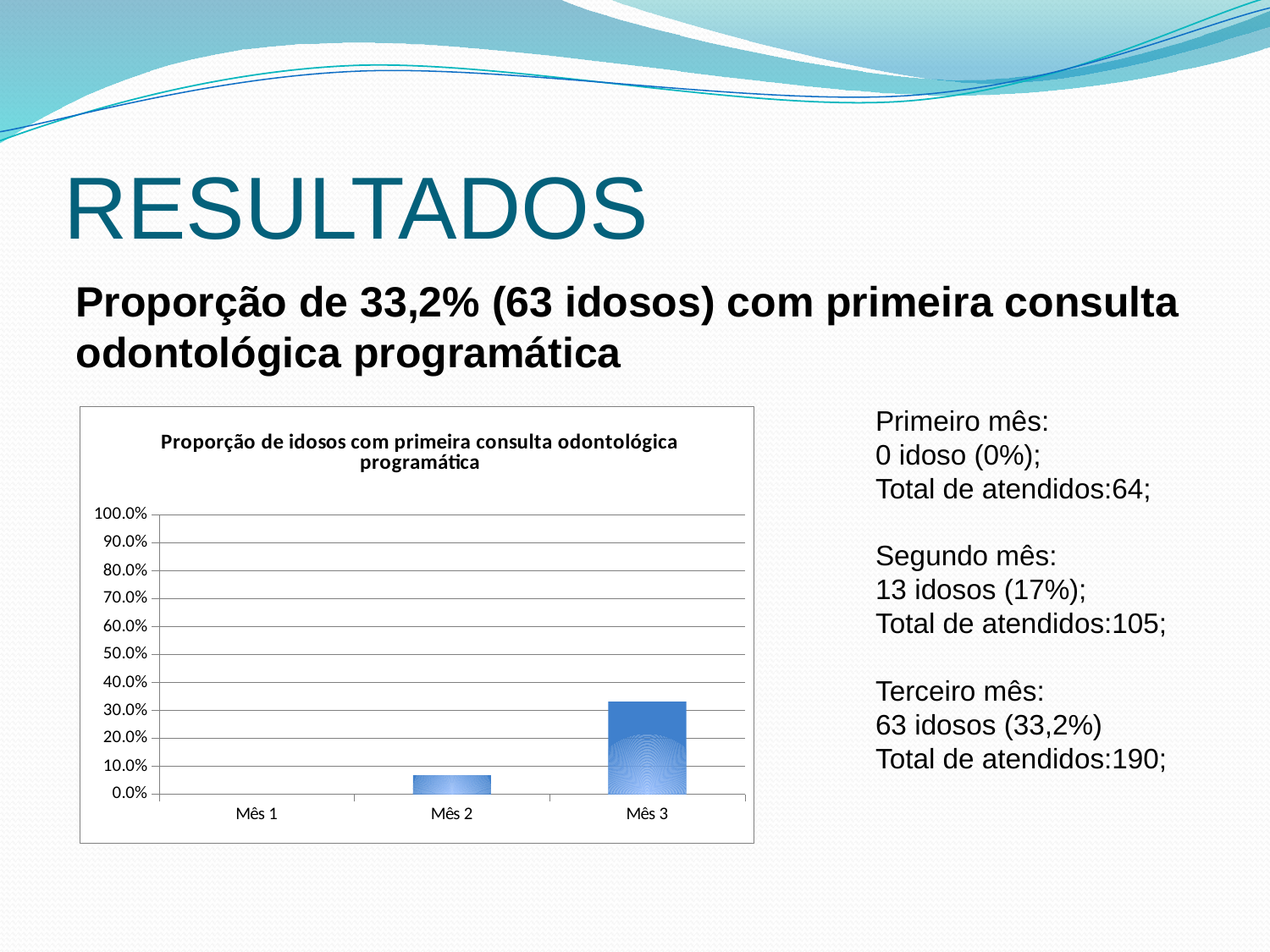
Which is larger in the chart, the value for Mês 2 or the value for Mês 3? Mês 3 Which month has the highest proportion in the chart? Mês 3 Is the value for Mês 2 greater or less than 10.0%? less What is the highest value shown on the chart's y axis? 100.0% Is the value for Mês 3 greater or less than 50.0%? less Which month has the lowest proportion in the chart? Mês 1 How many categories are shown on the x axis of the chart? 3 What kind of chart is shown on the slide? bar chart Do the values rise or fall from Mês 1 to Mês 3? rise Is the value for Mês 3 greater or less than 20.0%? greater What is the title of the chart? Proporção de idosos com primeira consulta odontológica programática